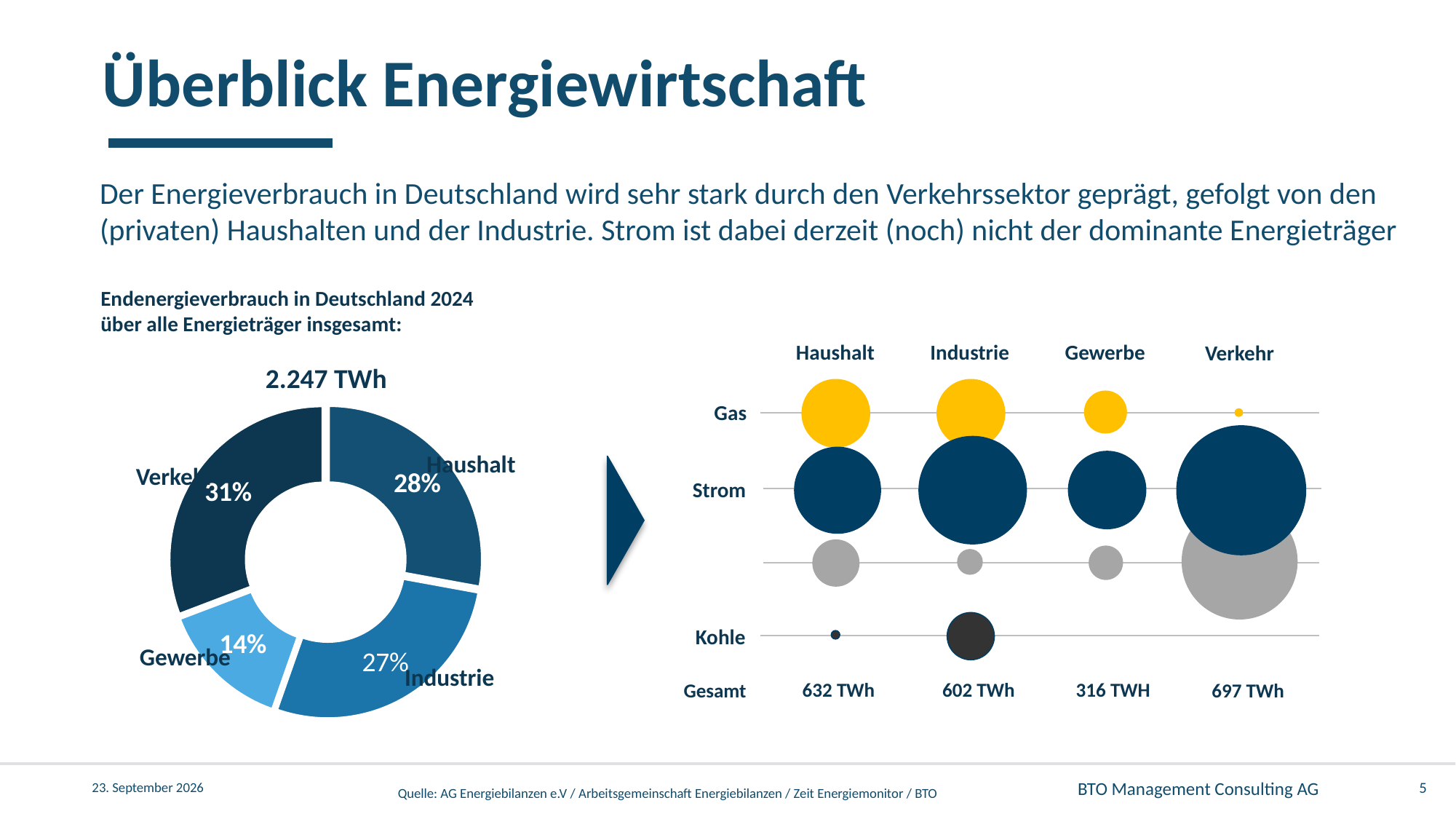
In the bubble chart on the right, what is the difference between the Gesamt values of Haushalt and Gewerbe? 316 TWh What total value is printed above the donut chart on the left? 2.247 TWh In the donut chart on the left, what share does Verkehr have? 31% What type of chart is shown on the left of the slide? Donut chart In the donut chart on the left, which is larger: Verkehr or Haushalt? Verkehr In the donut chart on the left, which category has the smallest share? Gewerbe In the donut chart on the left, which category has the largest share? Verkehr In the bubble chart on the right, what is the Gesamt value for Industrie? 602 TWh In the donut chart on the left, how many categories are shown? 4 In the donut chart on the left, what share does Gewerbe have? 14% In the bubble chart on the right, which sector has the highest Gesamt value? Verkehr In the donut chart on the left, what is the difference in percentage points between Haushalt and Industrie? 1